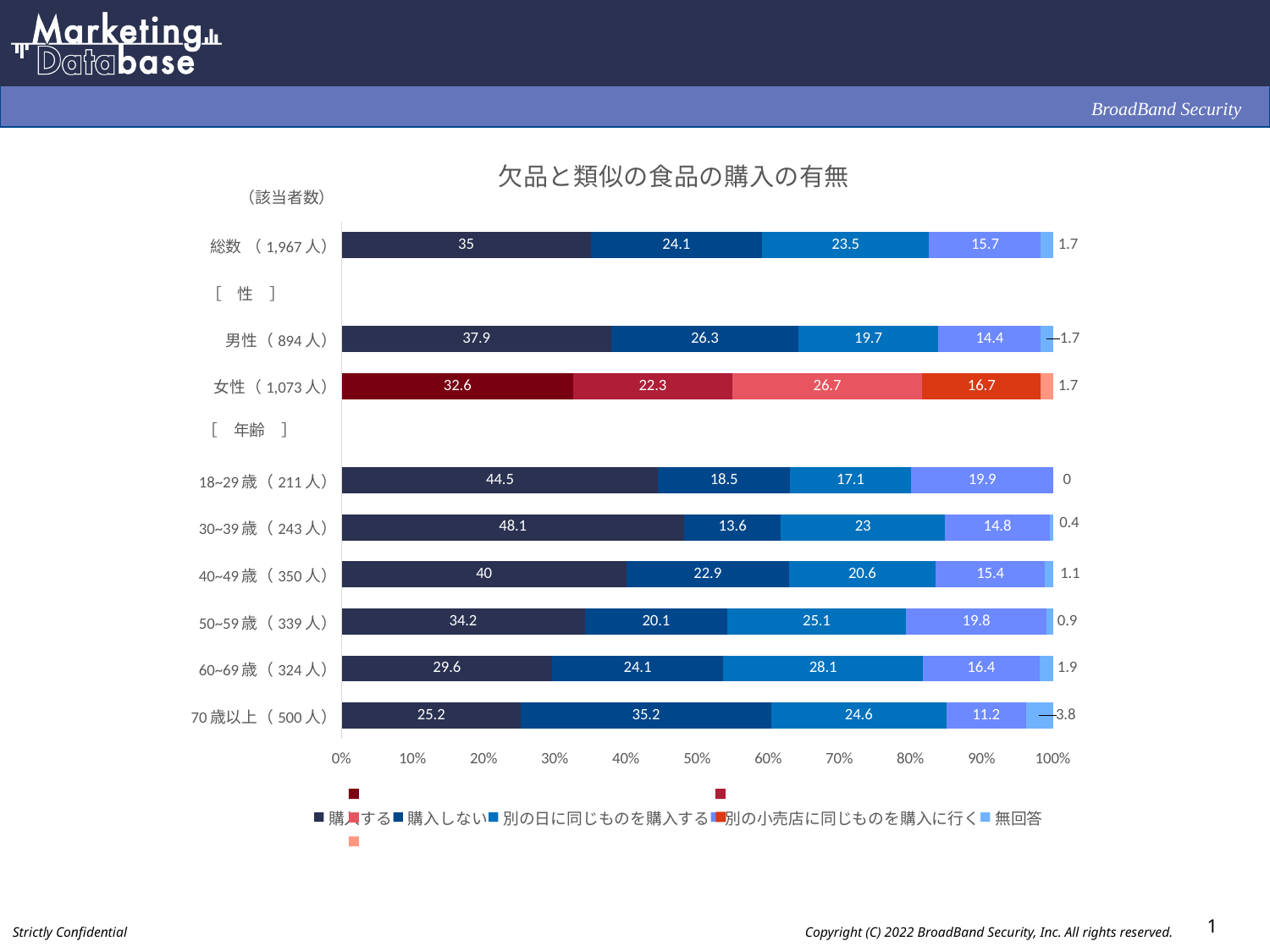
Which category has the highest value for 購入する? 30~39歳 (243人) Which is larger, the 別の日に同じものを購入する value for 男性 (894人) or for 女性 (1,073人)? 女性 (1,073人) What is the value of 別の小売店に同じものを購入に行く for 18~29歳 (211人)? 19.9 Which category has the lowest value for 購入する? 70歳以上 (500人) What is the value of 無回答 for 60~69歳 (324人)? 1.9 What is the difference between the 購入する values for 男性 (894人) and 女性 (1,073人)? 5.3 What is the value of 購入する for 総数 (1,967人)? 35 What is the value of 購入しない for 70歳以上 (500人)? 35.2 How many series does the legend list? 5 What is the title of the chart? 欠品と類似の食品の購入の有無 How many category bars are plotted in the chart? 9 What kind of chart is shown on the slide? Stacked bar chart